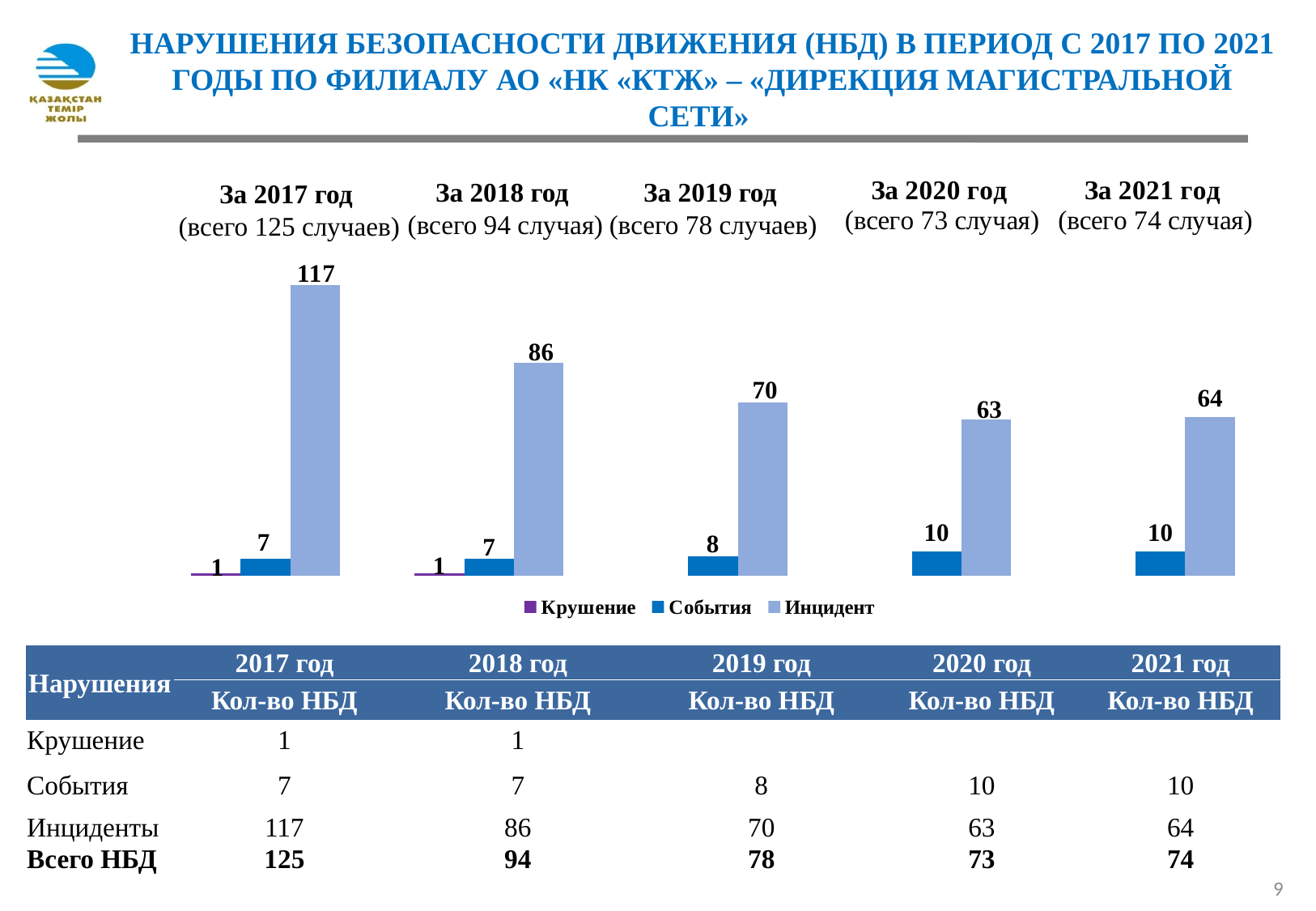
Does the Инцидент series rise or fall from 2017 to 2020? Fall What is the value of Инцидент for 2017 (За 2017 год)? 117 What kind of chart is shown on the slide? Bar chart Which is larger, the Инцидент value for 2019 or for 2021? 2019 What is the difference between the Инцидент values for 2017 and 2018? 31 How many year groups are shown in the chart? 5 In which year is the Инцидент bar the highest? 2017 What is the value of События for 2020 (За 2020 год)? 10 What is the value of Крушение for 2018 (За 2018 год)? 1 Which series is shown in light blue in the legend? Инцидент How many series does the legend list? 3 In which year is the Инцидент bar the lowest? 2020